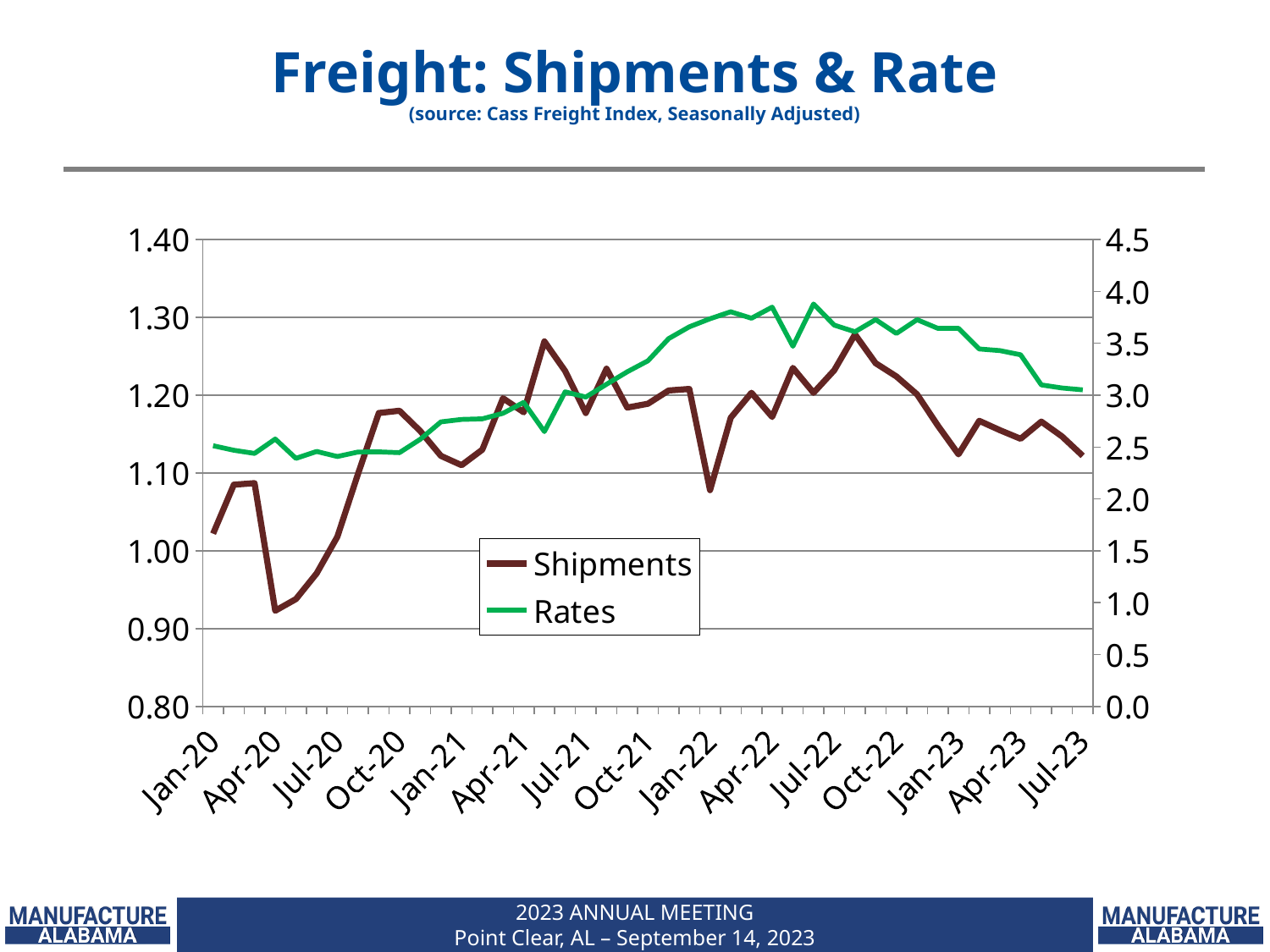
Is the Rates value for Jan-22 greater or less than 3.5? greater Is the Shipments value for Jan-22 greater or less than 1.10? less What is the title of the chart? Freight: Shipments & Rate In which month is the Shipments value lowest? Apr-20 Is the Rates value for Jul-20 greater or less than 3.0? less Do the Shipments values generally rise or fall from Sep-22 to Jul-23? fall How many series does the legend list? 2 What kind of chart is shown on the slide? line chart What are the two series named in the legend? Shipments and Rates Which is larger, the Shipments value for Jan-20 or for Apr-20? Jan-20 Do the Rates values generally rise or fall from Jan-20 to Jul-22? rise